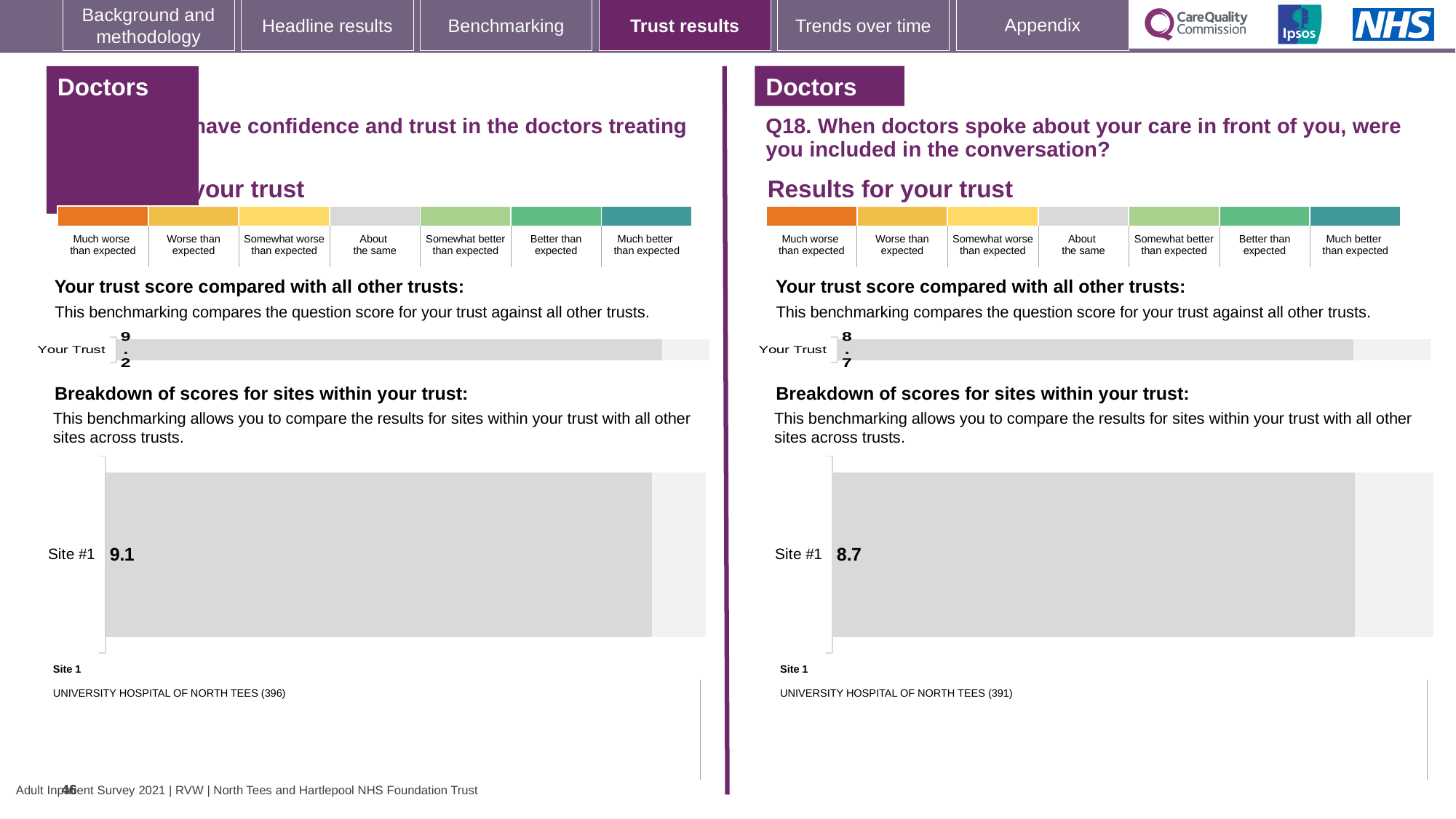
How many sites are plotted in the left-hand site breakdown chart? 1 On the right half of the slide (Q18), what is the value shown for Your Trust in the trust score chart? 8.7 What type of chart is used to show the Site #1 score on the left half of the slide? bar chart What is the difference between the Site #1 score on the left half of the slide (9.1) and the Site #1 score on the right half (8.7)? 0.4 In the right-hand site breakdown chart (Q18), what is the score for Site #1? 8.7 Which site name is listed as Site 1 beneath the right-hand site breakdown chart (Q18)? UNIVERSITY HOSPITAL OF NORTH TEES (391) On the left half of the slide, what is the value shown for Your Trust in the trust score chart? 9.2 In the left-hand site breakdown chart, what is the score for Site #1? 9.1 Which is larger: the Your Trust score on the left half of the slide or the Your Trust score on the right half (Q18)? Left (9.2) How many sites are plotted in the right-hand site breakdown chart (Q18)? 1 What is the category label on the y axis of the trust score chart on the right half of the slide (Q18)? Your Trust What is the difference between the Your Trust score on the left half of the slide (9.2) and the Your Trust score on the right half (8.7)? 0.5